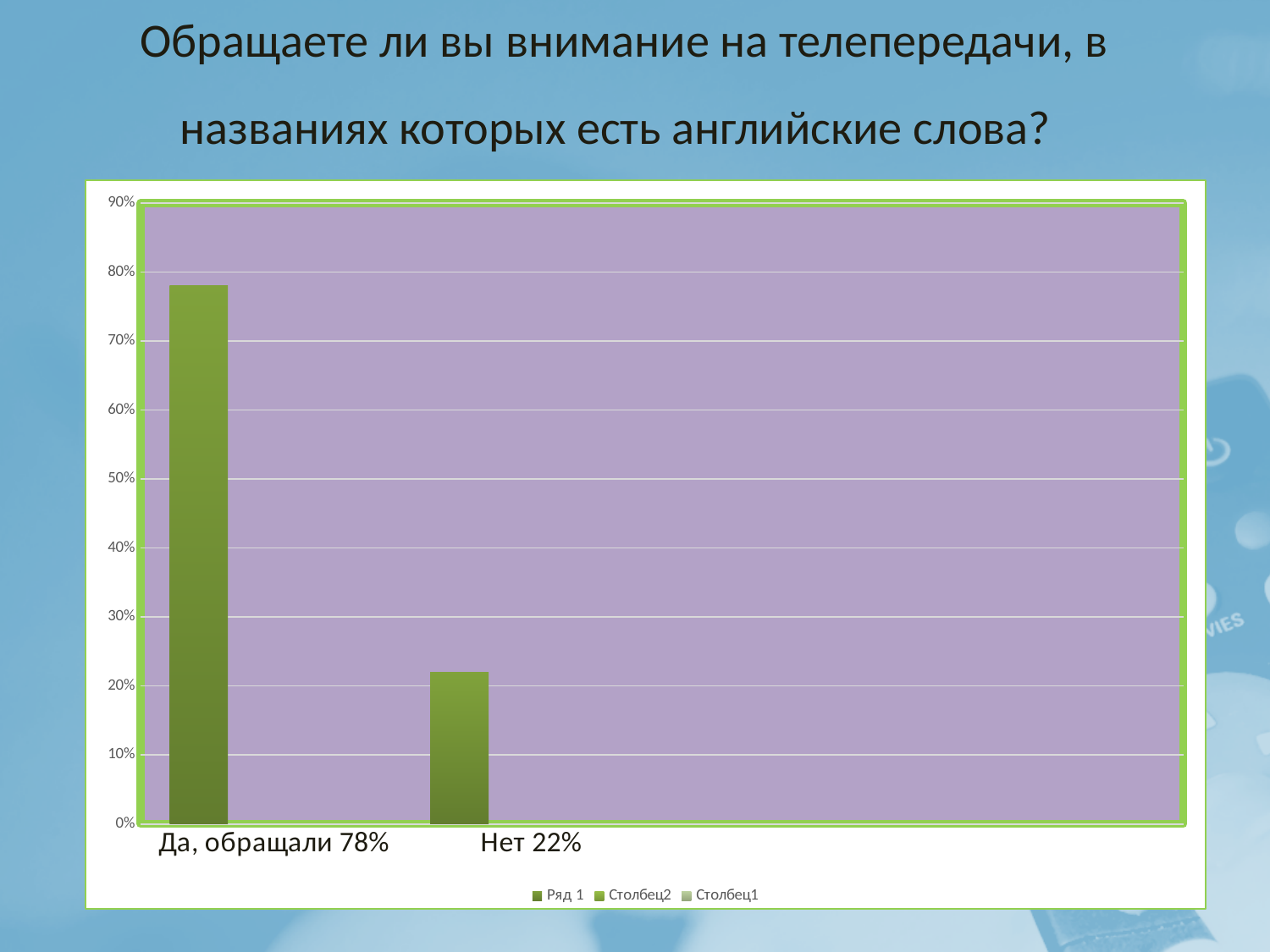
Which category has the lowest value? Нет What is the difference between the values for "Да, обращали" and "Нет"? 56% How many series does the legend list? 3 What is the first entry listed in the chart legend? Ряд 1 Is the value for "Да, обращали" greater or less than 70%? greater How many categories (bars) does the chart show? 2 Which category has the highest value? Да, обращали Which is larger, the value for "Да, обращали" or the value for "Нет"? Да, обращали Is the value for "Нет" greater or less than 30%? less What kind of chart is shown on the slide? bar chart What percentage is shown for the category "Да, обращали"? 78% What percentage is shown for the category "Нет"? 22%